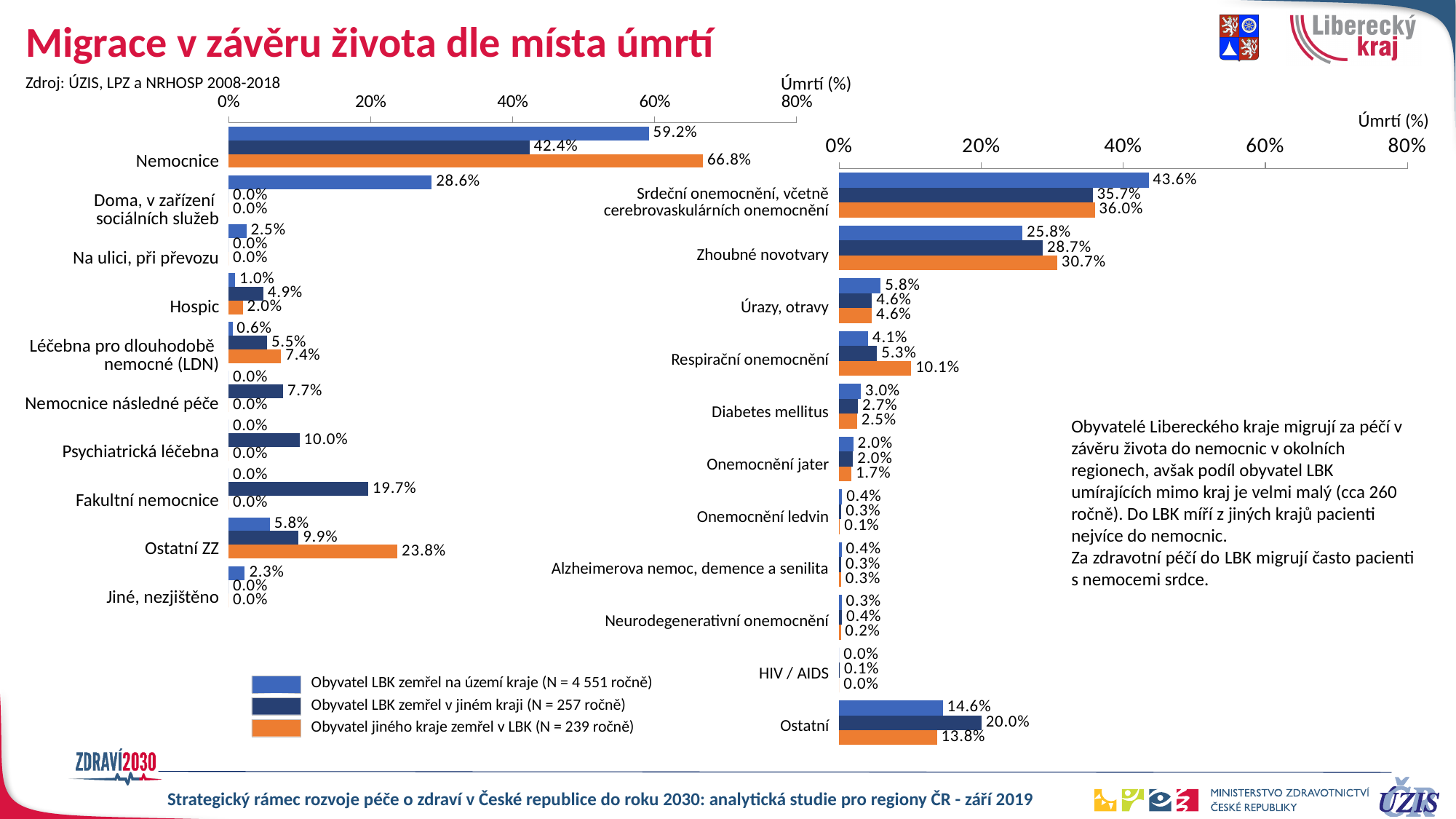
In the right chart (cause of death), what is the value for Zhoubné novotvary in the series 'Obyvatel jiného kraje zemřel v LBK'? 30.7% In the right chart (cause of death), which category has the highest value for the series 'Obyvatel LBK zemřel v jiném kraji'? Srdeční onemocnění, včetně cerebrovaskulárních onemocnění How many categories are shown in the left chart (place of death)? 10 In the right chart (cause of death), for Zhoubné novotvary, which is larger: the value for 'Obyvatel LBK zemřel na území kraje' or for 'Obyvatel LBK zemřel v jiném kraji'? Obyvatel LBK zemřel v jiném kraji In the right chart (cause of death), what is the value for Ostatní in the series 'Obyvatel LBK zemřel v jiném kraji'? 20.0% How many series does the legend list? 3 What kind of chart is the right chart (cause of death)? Bar chart In the left chart (place of death), which category has the highest value for the series 'Obyvatel LBK zemřel na území kraje'? Nemocnice In the left chart (place of death), what is the difference between the 'Obyvatel jiného kraje zemřel v LBK' value and the 'Obyvatel LBK zemřel v jiném kraji' value for Nemocnice? 24.4 percentage points In the left chart (place of death), what is the value for Fakultní nemocnice in the series 'Obyvatel LBK zemřel v jiném kraji'? 19.7% In the left chart (place of death), what is the value for Nemocnice in the series 'Obyvatel jiného kraje zemřel v LBK'? 66.8% In the right chart (cause of death), what is the value for Respirační onemocnění in the series 'Obyvatel jiného kraje zemřel v LBK'? 10.1%